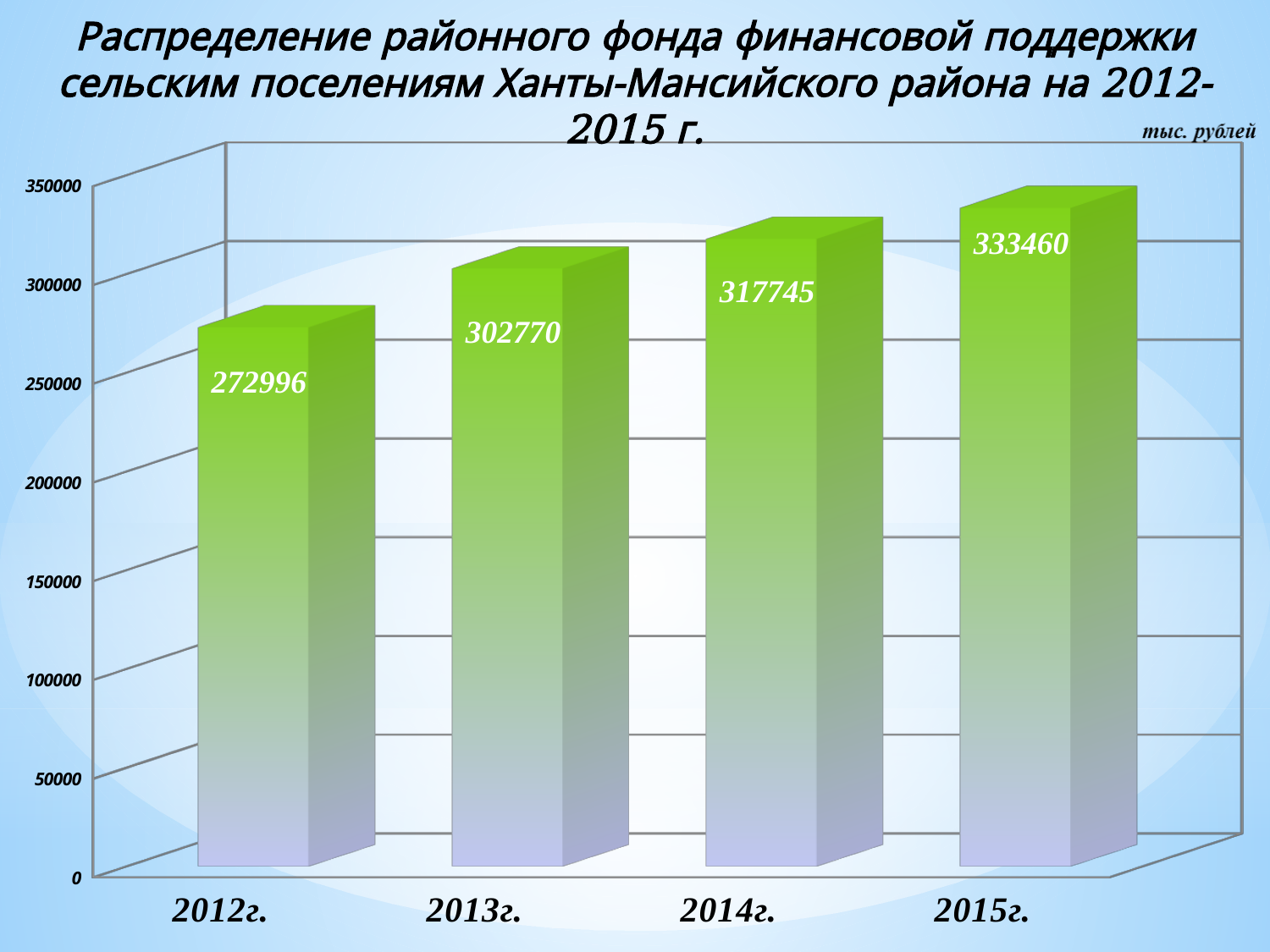
What is the value for 2014г.? 317745 Which year has the highest value? 2015г. What kind of chart is shown on the slide? bar chart What is the value for 2012г.? 272996 Which year has the lowest value? 2012г. How many years are shown on the x axis? 4 What is the difference between the values for 2015г. and 2012г.? 60464 Which is larger, the value for 2013г. or the value for 2014г.? 2014г. What is the value for 2015г.? 333460 Is the value for 2013г. greater or less than 300000? greater Do the values rise or fall from 2012г. to 2015г.? rise What is the difference between the values for 2013г. and 2012г.? 29774